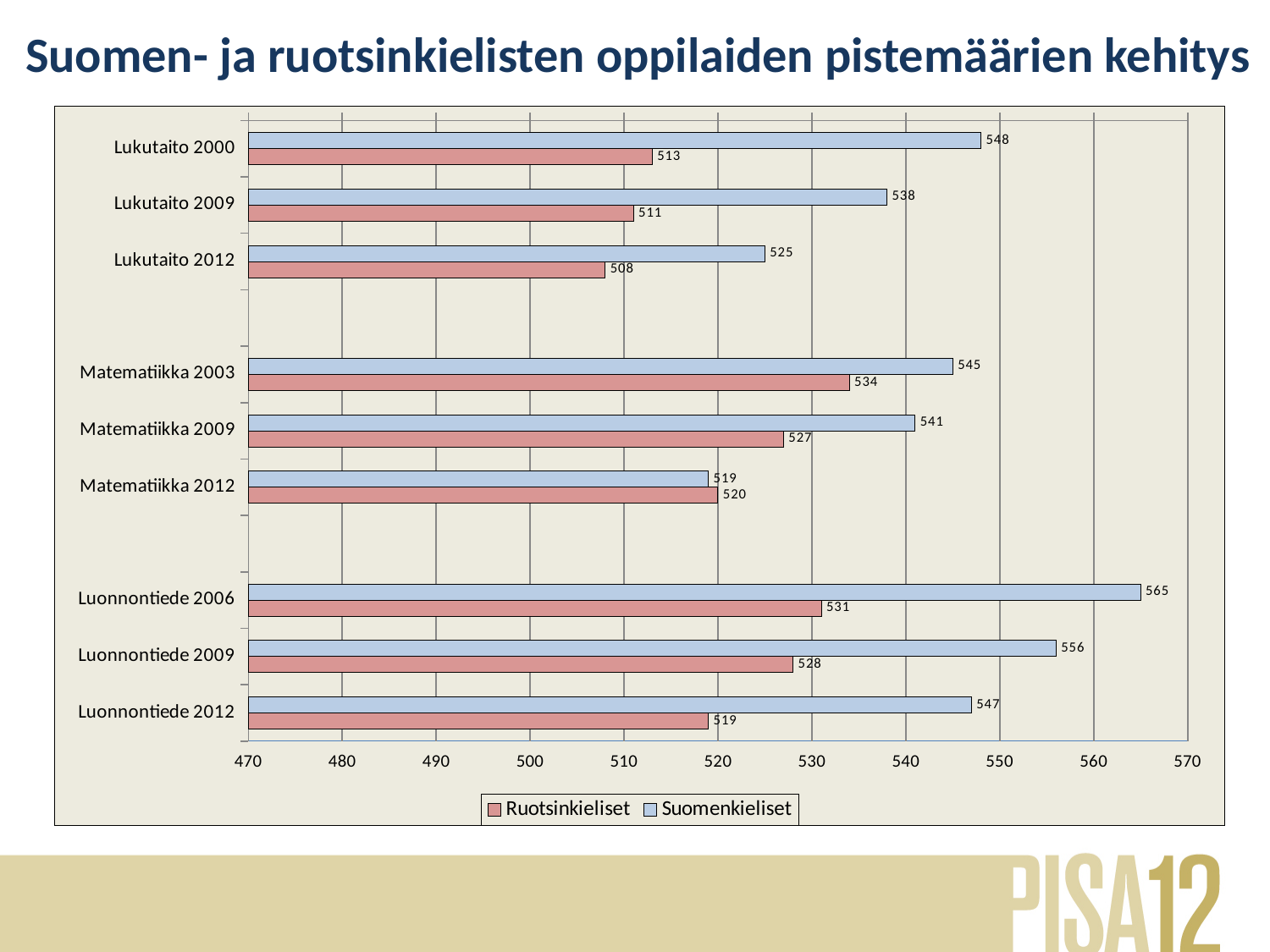
What is the difference between the Suomenkieliset values for Lukutaito 2000 and Lukutaito 2012? 23 What is the Ruotsinkieliset value for Luonnontiede 2012? 519 What kind of chart is shown on the slide? Bar chart Which is larger for Matematiikka 2012, the Ruotsinkieliset value or the Suomenkieliset value? Ruotsinkieliset Which category has the lowest Ruotsinkieliset value? Lukutaito 2012 Which category has the highest Suomenkieliset value? Luonnontiede 2006 What is the Suomenkieliset value for Lukutaito 2000? 548 What is the Ruotsinkieliset value for Matematiikka 2009? 527 How many series does the legend list? 2 What is the difference between the Suomenkieliset and Ruotsinkieliset values for Luonnontiede 2006? 34 How many categories are shown on the chart? 9 Do the Suomenkieliset values for Luonnontiede rise or fall from 2006 to 2012? Fall